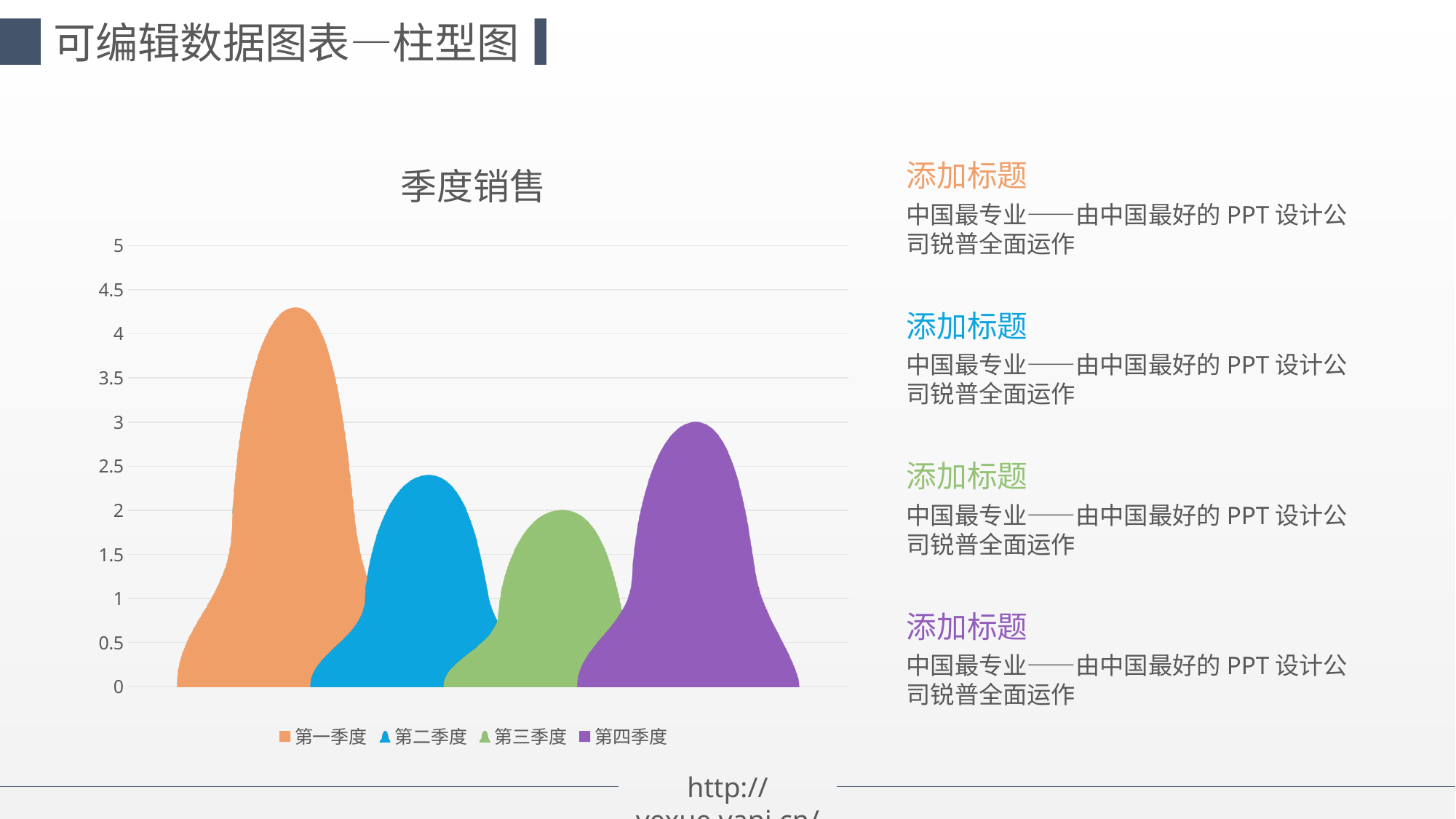
Which series has the highest value? 第一季度 How many series does the legend list? 4 What is the title of the chart? 季度销售 Is the value for 第一季度 greater or less than 4? greater Is the value for 第四季度 greater or less than 3.5? less Is the value for 第二季度 greater or less than 2.5? less What colour represents 第二季度 in the legend? blue Which is larger, the value for 第二季度 or the value for 第四季度? 第四季度 What kind of chart is shown under the title 季度销售? bar chart Which series has the lowest value? 第三季度 Which is larger, the value for 第一季度 or the value for 第三季度? 第一季度